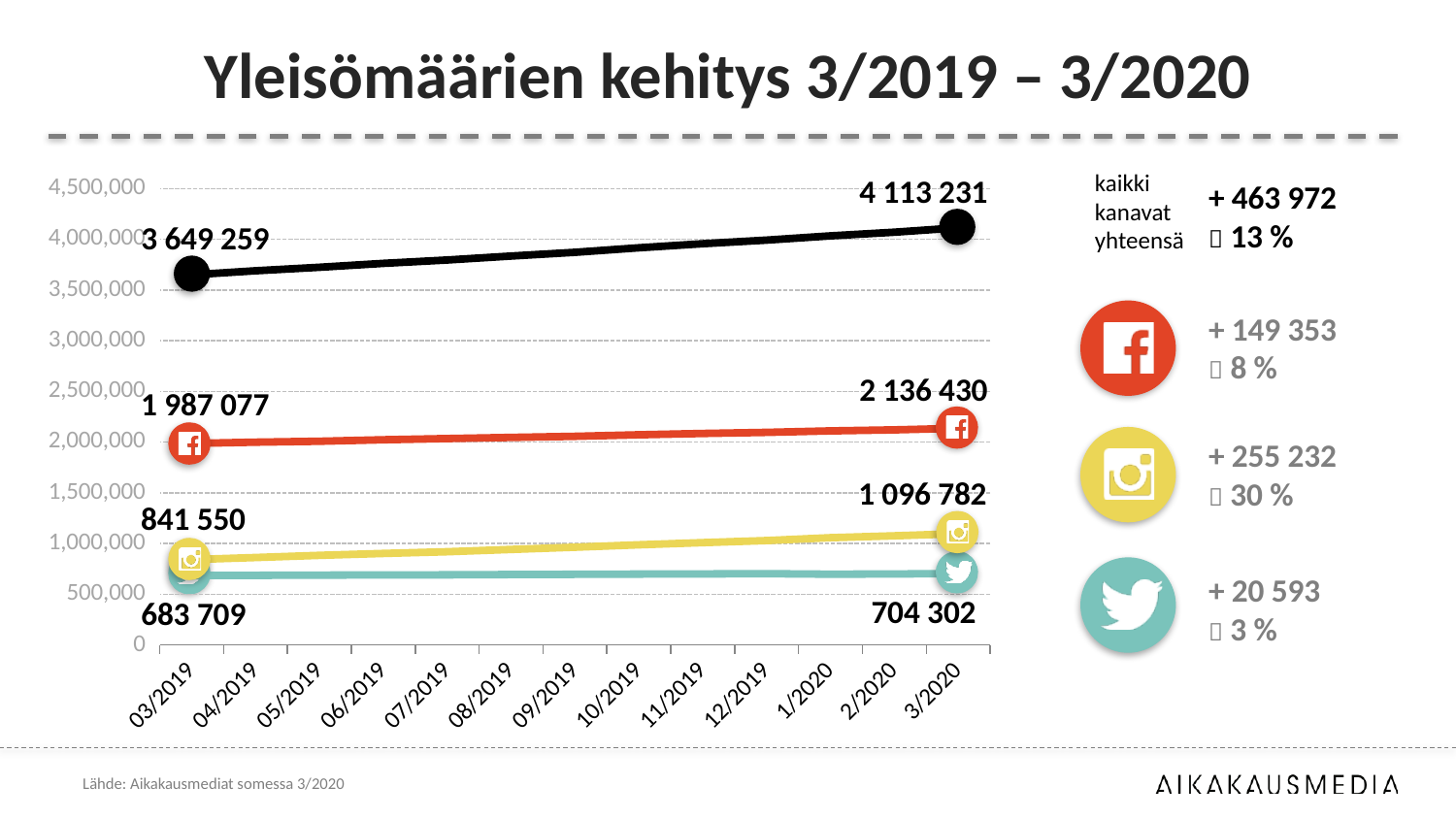
How many time points are shown on the x axis? 13 What is the value of the black line (kaikki kanavat yhteensä) at 03/2019? 3 649 259 What kind of chart is shown on the slide? Line chart Which of the three individual channels has the lowest value at 03/2019? Twitter What is the Instagram audience value at 03/2019? 841 550 By how much did the total (kaikki kanavat yhteensä) grow from 03/2019 to 3/2020? 463 972 What is the Twitter audience value at 3/2020? 704 302 At 3/2020, which is larger: the Instagram value or the Twitter value? Instagram Does the Facebook line rise or fall from 03/2019 to 3/2020? Rises Which of the three individual channels (Facebook, Instagram, Twitter) has the highest value at 3/2020? Facebook What is the difference between the Instagram values at 3/2020 and 03/2019? 255 232 What is the Facebook audience value at 3/2020? 2 136 430